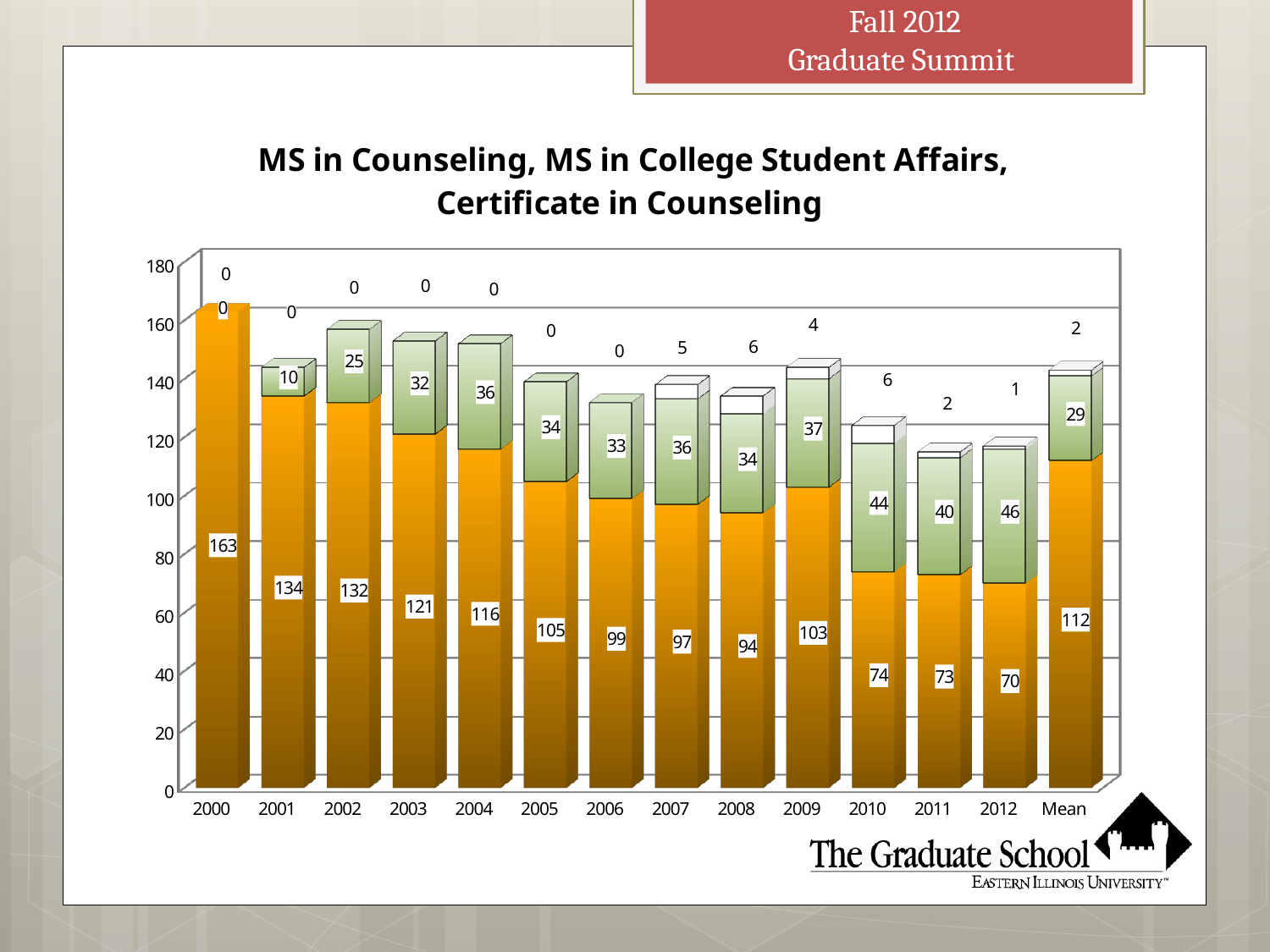
What is the difference between the orange segment values for 2000 and 2012? 93 What is the value of the orange segment for 2000? 163 Which year has the lowest value for the orange segment? 2012 What is the total of the stacked bar for 2012? 117 What is the value of the orange segment for the Mean category? 112 Do the orange segment values generally rise or fall from 2000 to 2012? Fall Which year has the highest value for the orange segment? 2000 How many categories are shown along the x axis? 14 What is the value of the green segment for 2012? 46 What type of chart is shown on the slide? Stacked bar chart Which is larger, the green segment for 2010 or the green segment for 2011? 2010 What is the value of the top (white) segment for 2008? 6